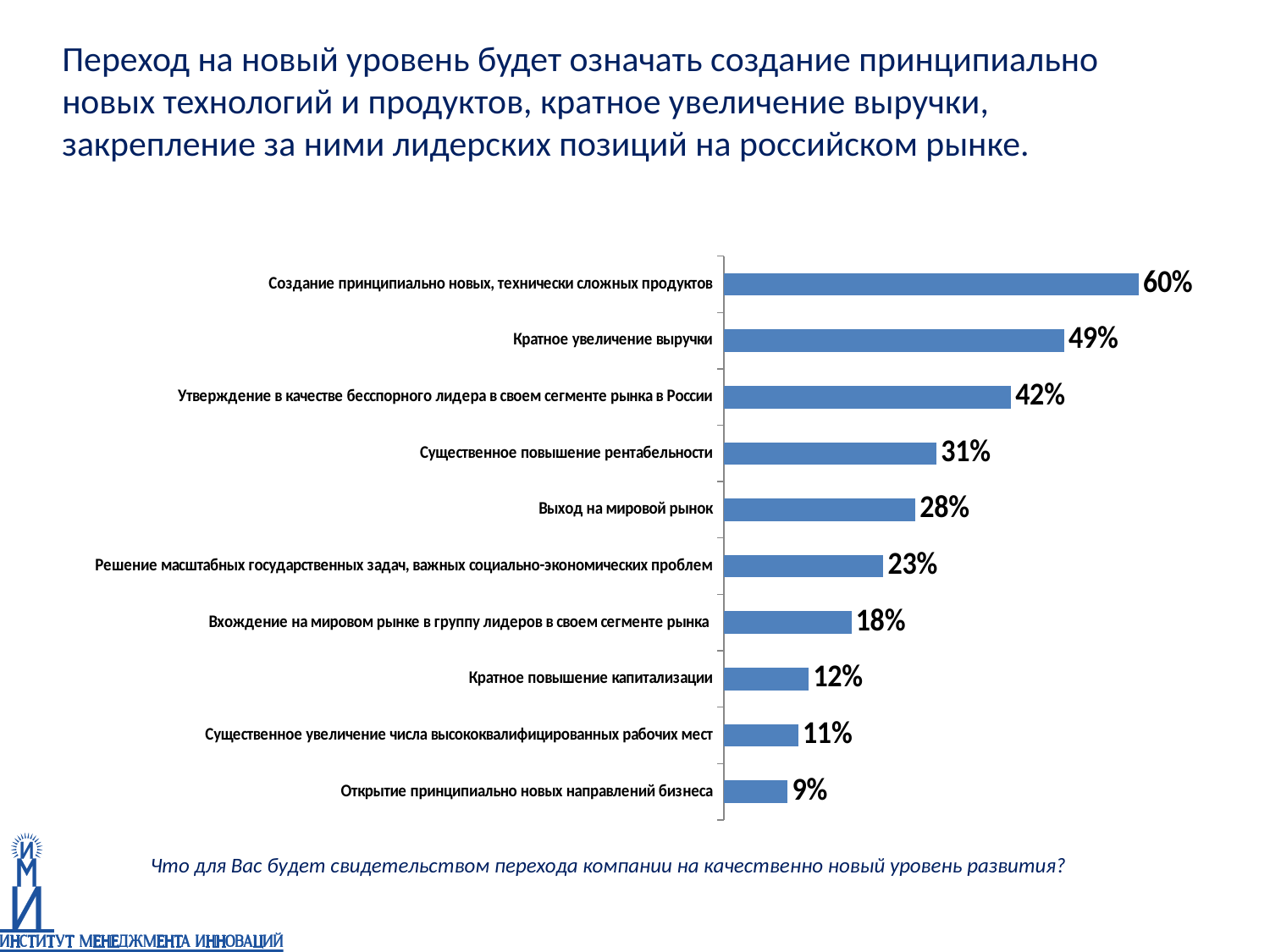
What is the difference between the values for "Существенное повышение рентабельности" and "Выход на мировой рынок"? 3% How many categories are shown in the chart? 10 What is the difference between the values for "Создание принципиально новых, технически сложных продуктов" and "Кратное увеличение выручки"? 11% What kind of chart is shown on the slide? Bar chart What survey question is written below the chart? Что для Вас будет свидетельством перехода компании на качественно новый уровень развития? What value is shown for "Выход на мировой рынок"? 28% Which category has the highest value? Создание принципиально новых, технически сложных продуктов What value is shown for "Кратное повышение капитализации"? 12% Which category has the lowest value? Открытие принципиально новых направлений бизнеса Which is larger: the value for "Утверждение в качестве бесспорного лидера в своем сегменте рынка в России" or the value for "Существенное повышение рентабельности"? Утверждение в качестве бесспорного лидера в своем сегменте рынка в России What value is shown for "Решение масштабных государственных задач, важных социально-экономических проблем"? 23% What value is shown for "Кратное увеличение выручки"? 49%